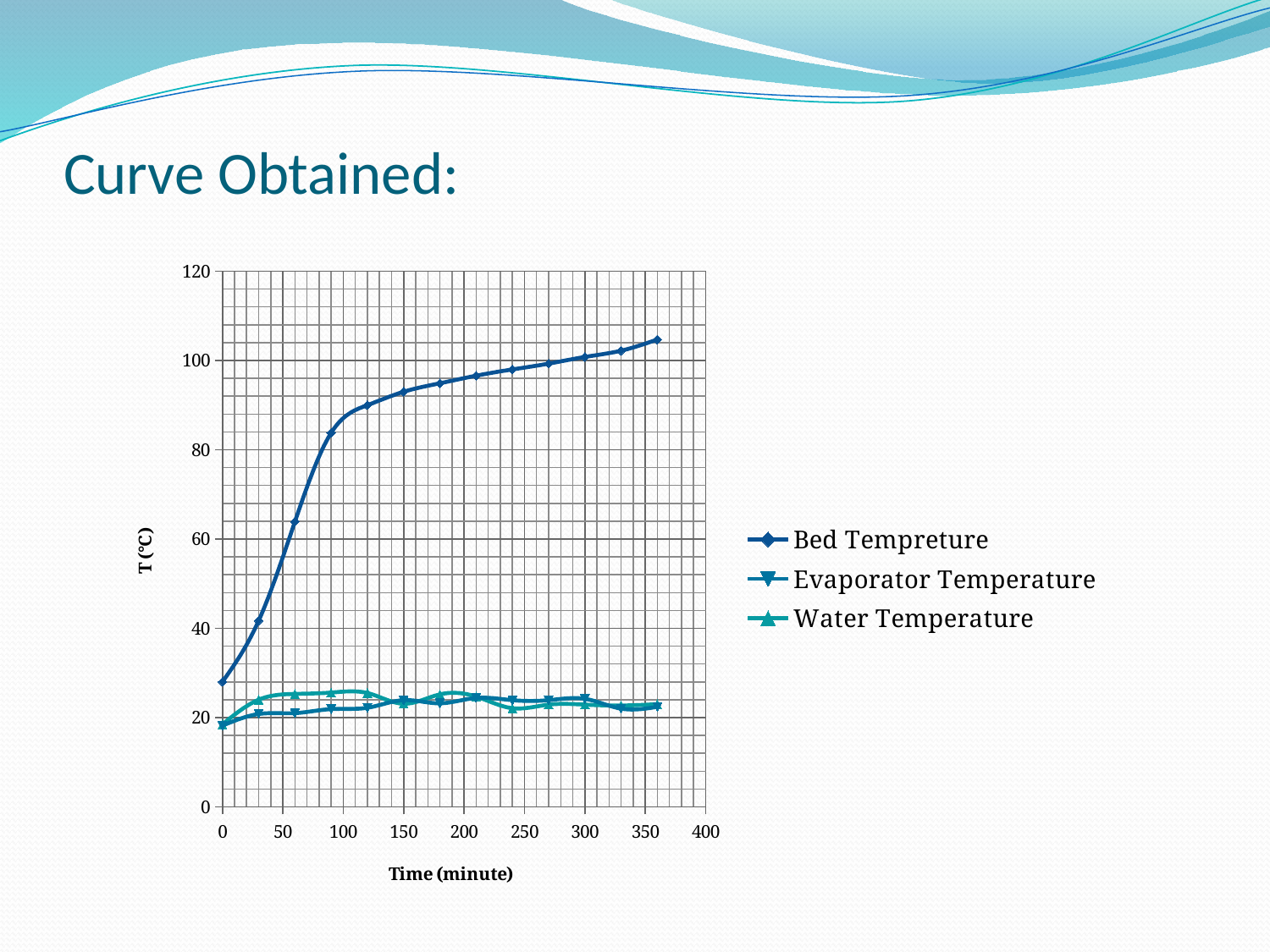
Which series has the highest value at 360 minutes? Bed Tempreture What are the three series named in the legend? Bed Tempreture, Evaporator Temperature, Water Temperature Is the Bed Tempreture value at 0 minutes greater or less than 40? less Is the Evaporator Temperature value at 360 minutes greater or less than 40? less Does the Bed Tempreture series rise or fall as time increases? rise Is the Bed Tempreture value at 360 minutes greater or less than 100? greater What is the title of the x axis? Time (minute) What kind of chart is shown on the slide? line chart How many series does the legend list? 3 At 300 minutes, which is larger: Bed Tempreture or Water Temperature? Bed Tempreture How many data points are plotted for the Bed Tempreture series? 13